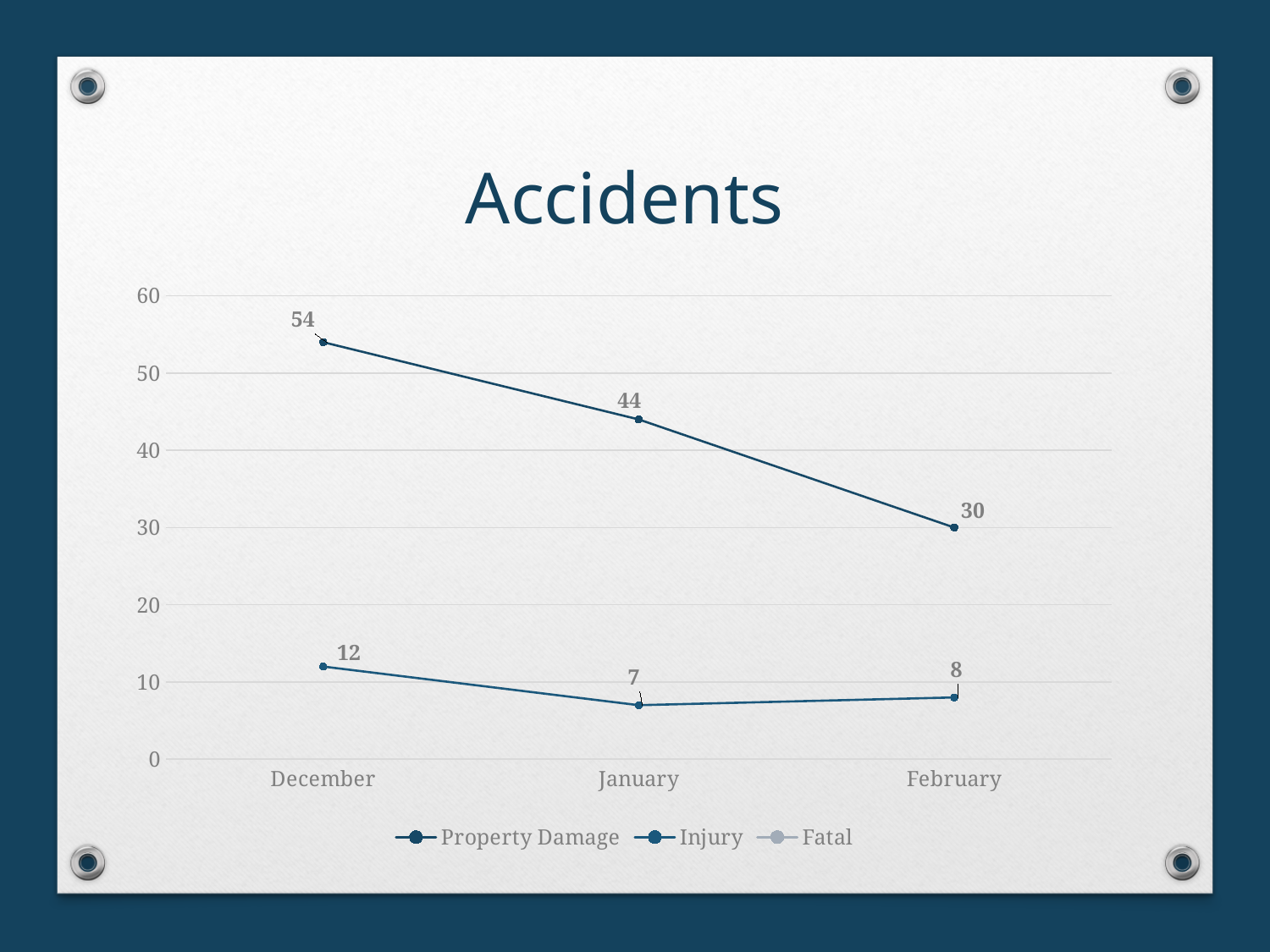
Which is larger, Property Damage in January or Injury in December? Property Damage in January What kind of chart is shown on the slide? line chart Does Property Damage rise or fall from December to February? fall In which month is Property Damage highest? December What is the difference between Property Damage in December and in February? 24 What is the Injury value for January? 7 What is the difference between Injury in December and in January? 5 What is the Injury value for February? 8 In which month is Injury lowest? January What is the Property Damage value for February? 30 How many series does the legend list? 3 What is the Property Damage value for December? 54